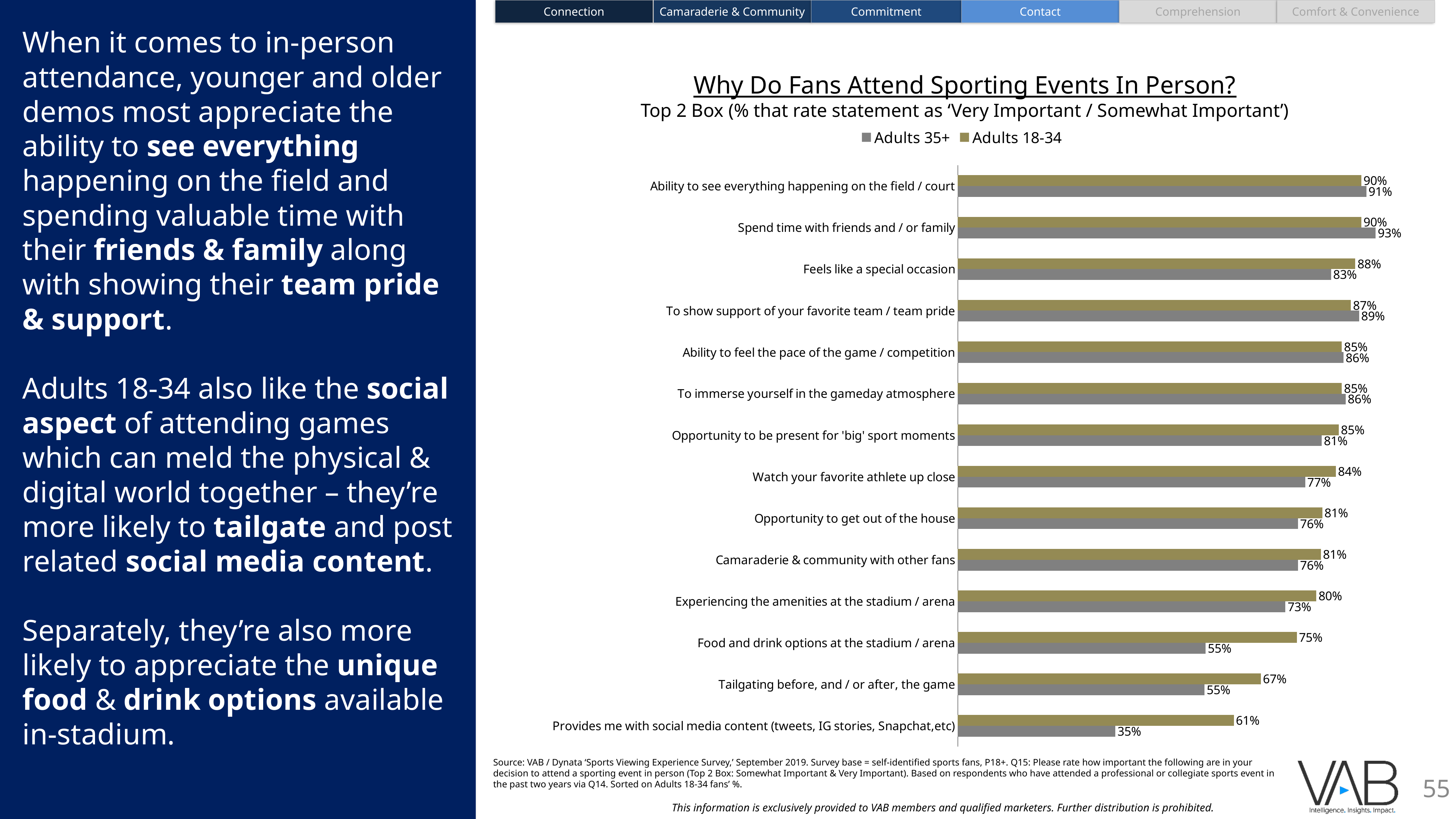
What is the difference between the Adults 18-34 and Adults 35+ values for 'Provides me with social media content (tweets, IG stories, Snapchat,etc)'? 26 percentage points For 'To show support of your favorite team / team pride', which group has the higher value, Adults 35+ or Adults 18-34? Adults 35+ What is the difference between the Adults 18-34 and Adults 35+ values for 'Tailgating before, and / or after, the game'? 12 percentage points What percentage of Adults 35+ rate 'Spend time with friends and / or family' as important? 93% What type of chart is shown on the slide? Bar chart Which statement has the highest value for Adults 35+? Spend time with friends and / or family What percentage of Adults 18-34 rate 'Provides me with social media content (tweets, IG stories, Snapchat,etc)' as important? 61% Which statement has the lowest value for Adults 18-34? Provides me with social media content (tweets, IG stories, Snapchat,etc) For 'Feels like a special occasion', which group has the higher value, Adults 35+ or Adults 18-34? Adults 18-34 How many statements (categories) are shown in the chart? 14 How many series does the legend list? 2 What is the Adults 35+ value for 'Food and drink options at the stadium / arena'? 55%